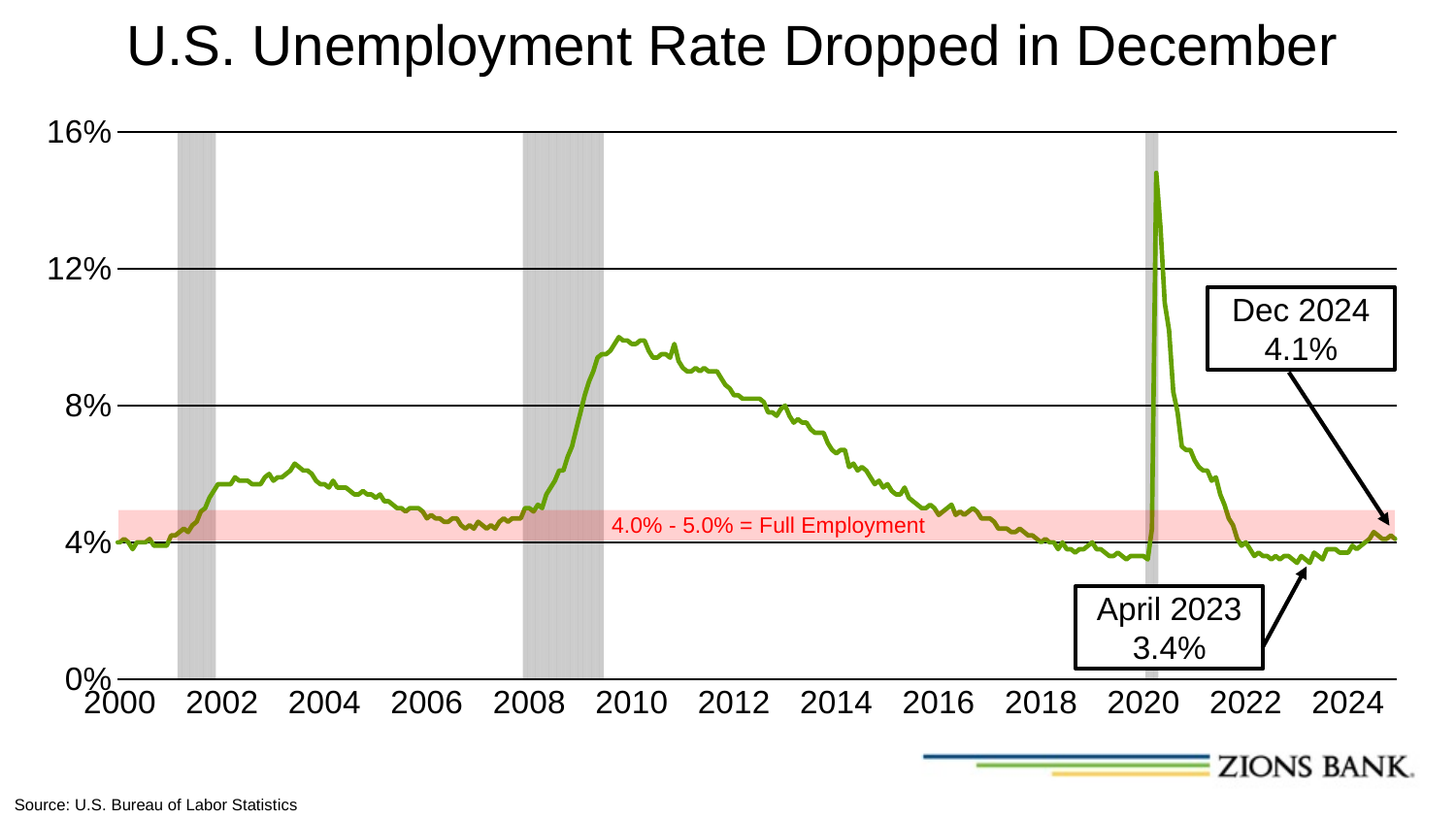
Which is larger, the labeled value for Dec 2024 or the labeled value for April 2023? Dec 2024 Is the peak unemployment rate reached in 2020 greater or less than 12%? greater What range does the shaded red band label as full employment? 4.0% - 5.0% What unemployment rate is labeled for Dec 2024? 4.1% By how many percentage points is the Dec 2024 value higher than the April 2023 value? 0.7 percentage points What is the title of the chart? U.S. Unemployment Rate Dropped in December What unemployment rate is labeled for April 2023? 3.4% Is the unemployment rate in 2016 greater or less than 8%? less Does the unemployment rate rise or fall between 2010 and 2019? Fall What type of chart is shown on the slide? Line chart In which year does the unemployment rate reach its highest point on the chart? 2020 Is the peak unemployment rate reached around 2010 greater or less than 8%? greater